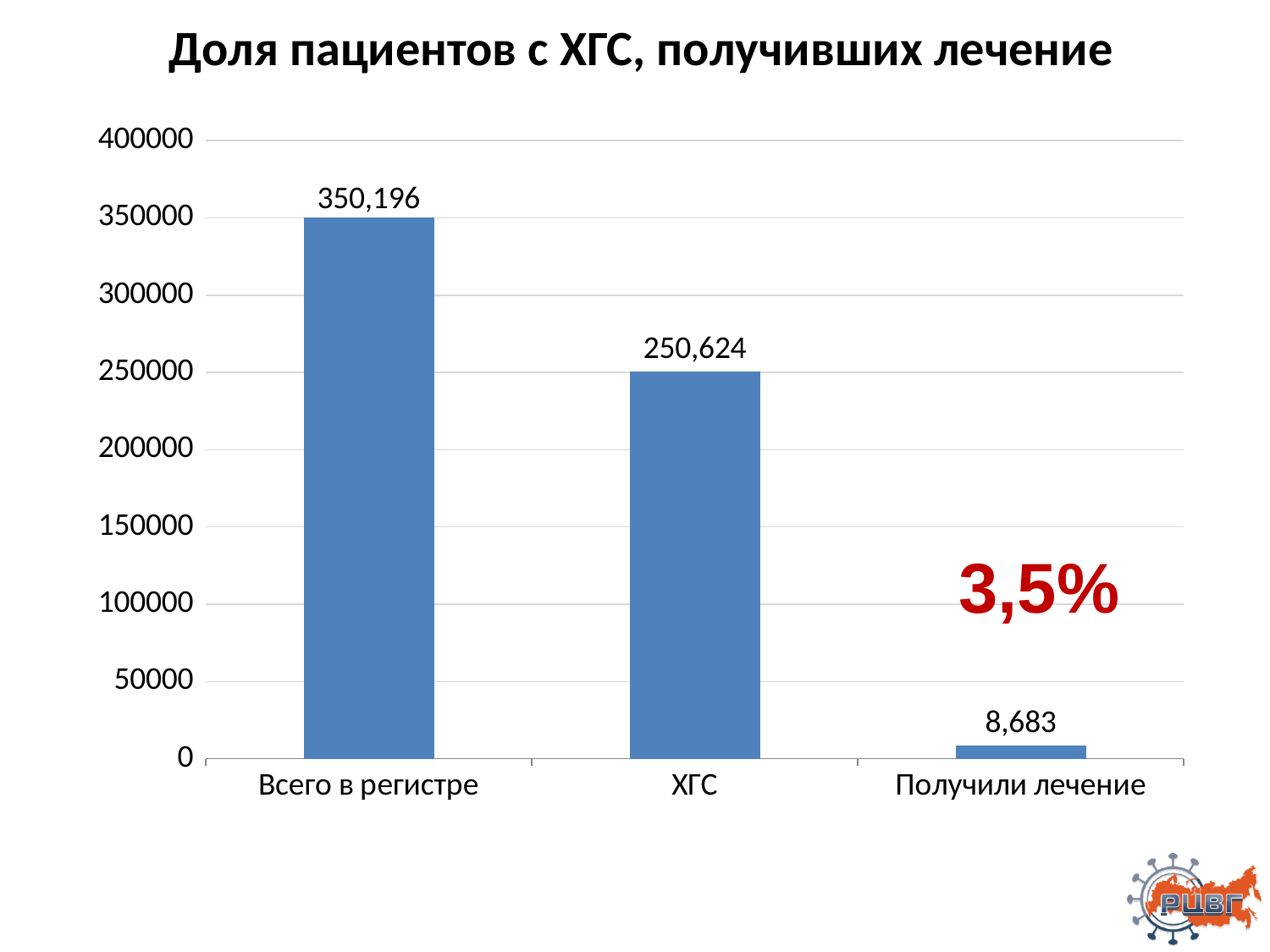
What is the difference between the values for ХГС and Получили лечение? 241,941 What is the value for ХГС? 250,624 What kind of chart is shown on the slide? bar chart What is the difference between the values for Всего в регистре and ХГС? 99,572 What is the value for Всего в регистре? 350,196 How many categories are shown on the x axis? 3 What percentage is printed in red on the chart? 3,5% Is the value for ХГС greater or less than 300000? less What is the value for Получили лечение? 8,683 Which category has the lowest value? Получили лечение Which is larger, the value for ХГС or the value for Получили лечение? ХГС Which category has the highest value? Всего в регистре